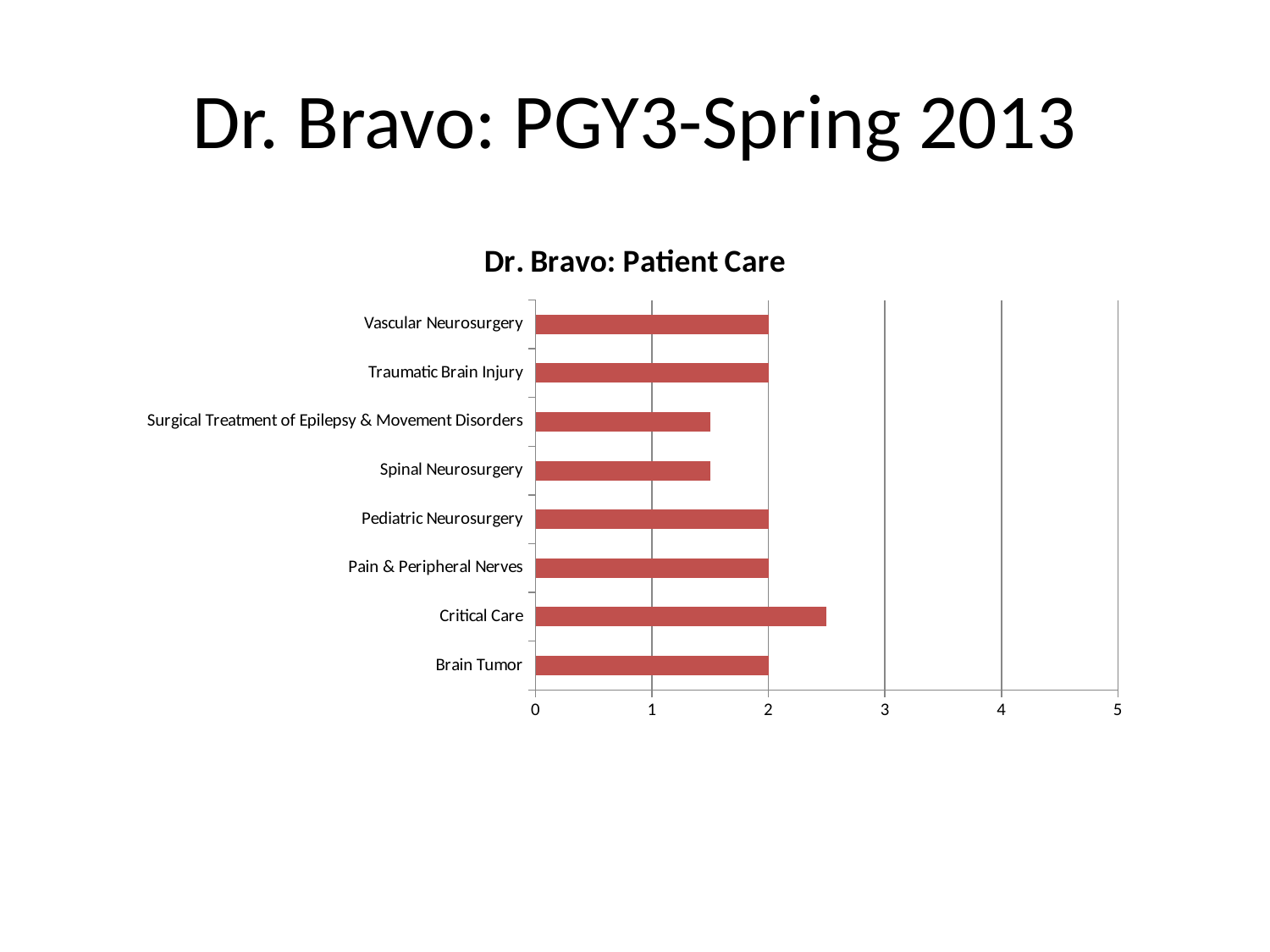
What is the title of the chart? Dr. Bravo: Patient Care Which is larger, the value for Critical Care or the value for Pain & Peripheral Nerves? Critical Care How many categories are plotted in the chart? 8 Which category has the highest value? Critical Care What kind of chart is shown on the slide? bar chart Is the value for Critical Care greater or less than 2? greater What is the value for Vascular Neurosurgery? 2 Is the value for Spinal Neurosurgery greater or less than 2? less Is the value for Surgical Treatment of Epilepsy & Movement Disorders greater or less than 1? greater What is the value for Pediatric Neurosurgery? 2 What is the value for Brain Tumor? 2 Which is larger, the value for Traumatic Brain Injury or the value for Spinal Neurosurgery? Traumatic Brain Injury